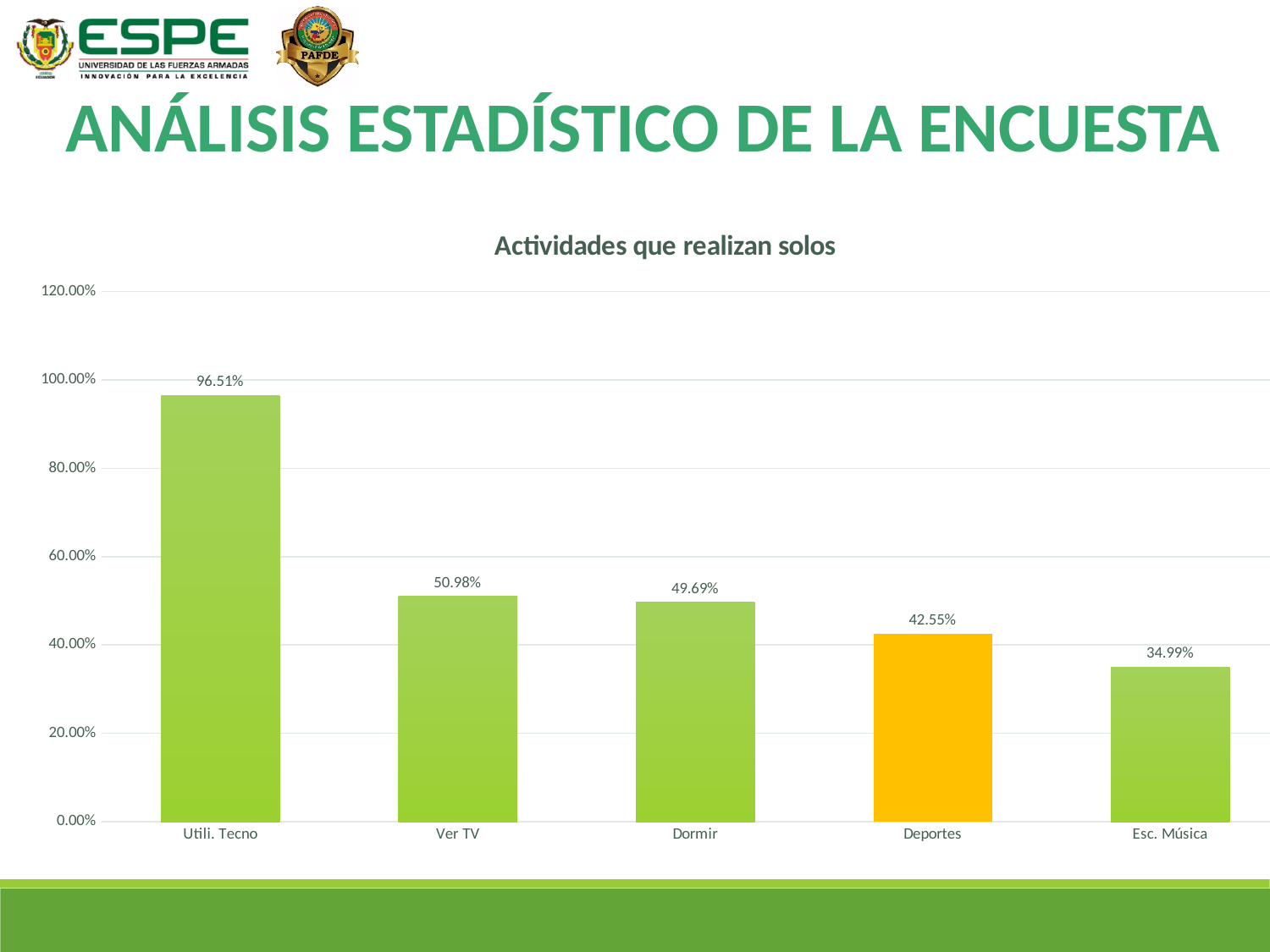
What is the difference between the values for Utili. Tecno and Ver TV? 45.53% What is the title of the chart? Actividades que realizan solos What kind of chart is shown on the slide? bar chart Is the value for Ver TV greater or less than 60.00%? less How many categories are shown on the x axis? 5 What is the difference between the values for Deportes and Esc. Música? 7.56% What is the value for Deportes? 42.55% Which category has the highest value? Utili. Tecno What is the value for Esc. Música? 34.99% Which is larger, the value for Dormir or the value for Deportes? Dormir What is the value for Utili. Tecno? 96.51% Which category has the lowest value? Esc. Música